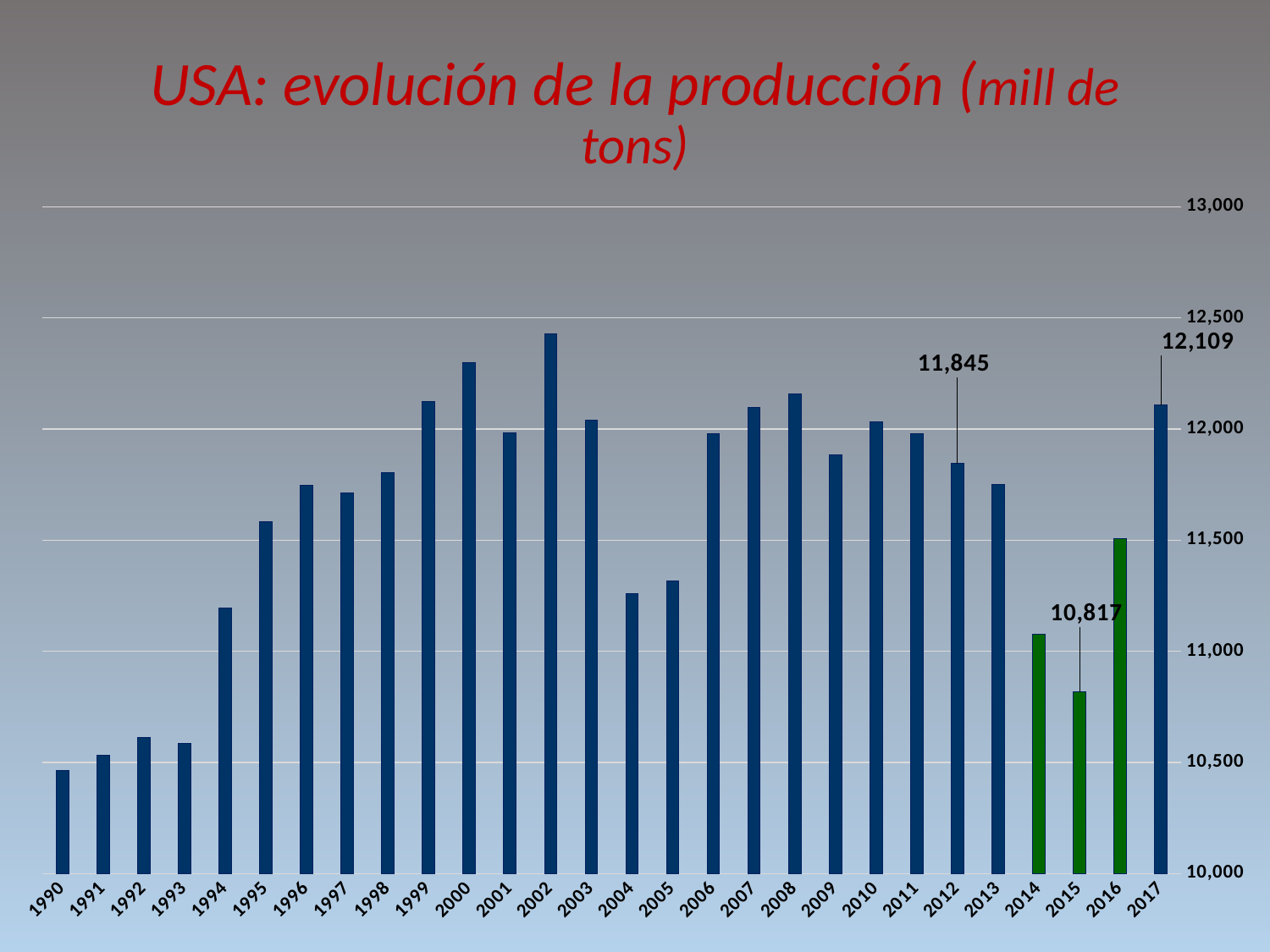
What is the difference between the values for 2012 and 2015? 1,028 What is the value for 2012? 11,845 Which year has the lowest bar? 1990 Which is larger, the value for 2002 or the value for 2004? 2002 What is the value for 2017? 12,109 What kind of chart is shown on the slide? bar chart How many years are shown on the x axis? 28 Which year has the highest bar? 2002 What is the difference between the values for 2017 and 2012? 264 Is the value for 1990 greater or less than 10,500? less What is the value for 2015? 10,817 Is the value for 2002 greater or less than 12,000? greater